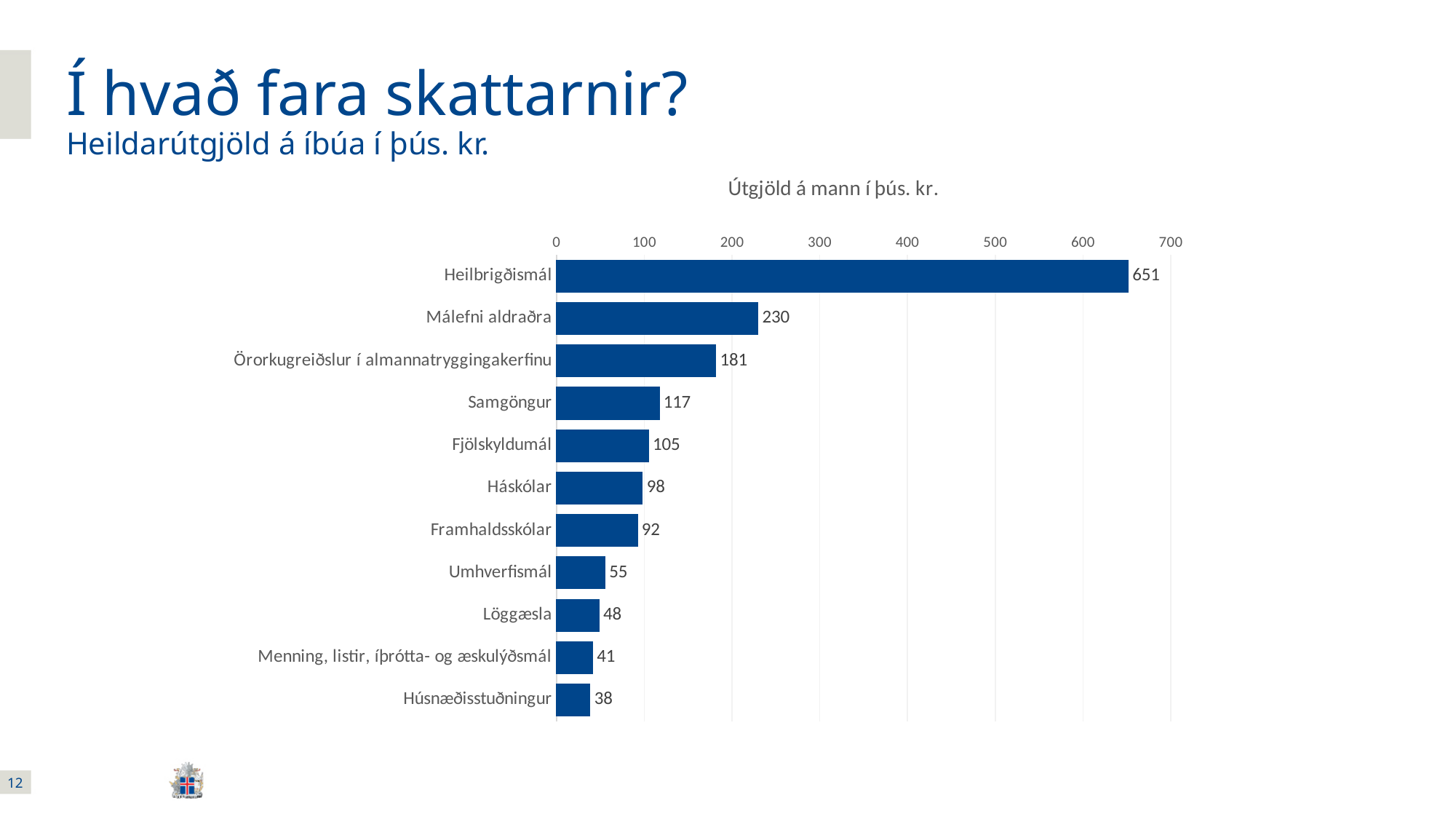
What is the value for Samgöngur? 117 What is the title of the chart? Útgjöld á mann í þús. kr. How many categories are shown in the chart? 11 What is the value for Örorkugreiðslur í almannatryggingakerfinu? 181 Which category has the lowest value? Húsnæðisstuðningur What is the difference between the values for Heilbrigðismál and Málefni aldraðra? 421 What is the difference between the values for Háskólar and Framhaldsskólar? 6 What kind of chart is shown on the slide? Bar chart What is the value for Húsnæðisstuðningur? 38 Which is larger, the value for Fjölskyldumál or the value for Umhverfismál? Fjölskyldumál Which category has the highest value? Heilbrigðismál What is the value for Heilbrigðismál? 651